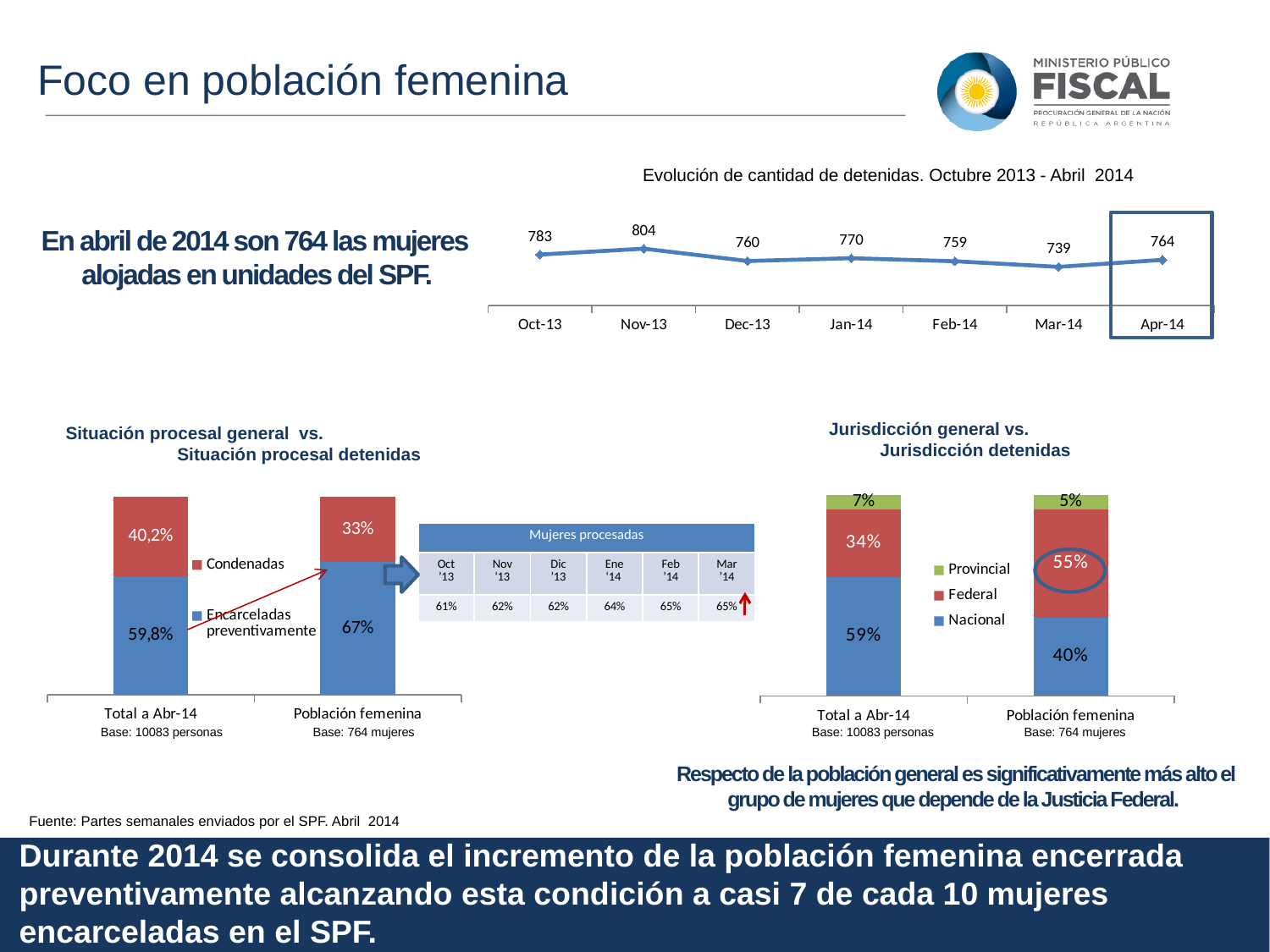
In the chart 'Situación procesal general vs. Situación procesal detenidas', which is larger: the 'Encarceladas preventivamente' share for Total a Abr-14 or for Población femenina? Población femenina In the line chart 'Evolución de cantidad de detenidas', which month has the lowest value? Mar-14 In the chart 'Situación procesal general vs. Situación procesal detenidas', what is the 'Condenadas' value for Total a Abr-14? 40,2% In the chart 'Situación procesal general vs. Situación procesal detenidas', what is the 'Encarceladas preventivamente' value for Población femenina? 67% In the line chart 'Evolución de cantidad de detenidas', what is the value for Nov-13? 804 In the chart 'Jurisdicción general vs. Jurisdicción detenidas', what is the 'Federal' value for Población femenina? 55% In the line chart 'Evolución de cantidad de detenidas', which month has the highest value? Nov-13 In the line chart 'Evolución de cantidad de detenidas', what is the difference between the Oct-13 and Apr-14 values? 19 What kind of chart is 'Evolución de cantidad de detenidas'? Line chart How many data points are plotted in the line chart 'Evolución de cantidad de detenidas'? 7 In the chart 'Jurisdicción general vs. Jurisdicción detenidas', what is the difference between the 'Nacional' values for Total a Abr-14 and Población femenina? 19% How many series does the legend of the chart 'Jurisdicción general vs. Jurisdicción detenidas' list? 3